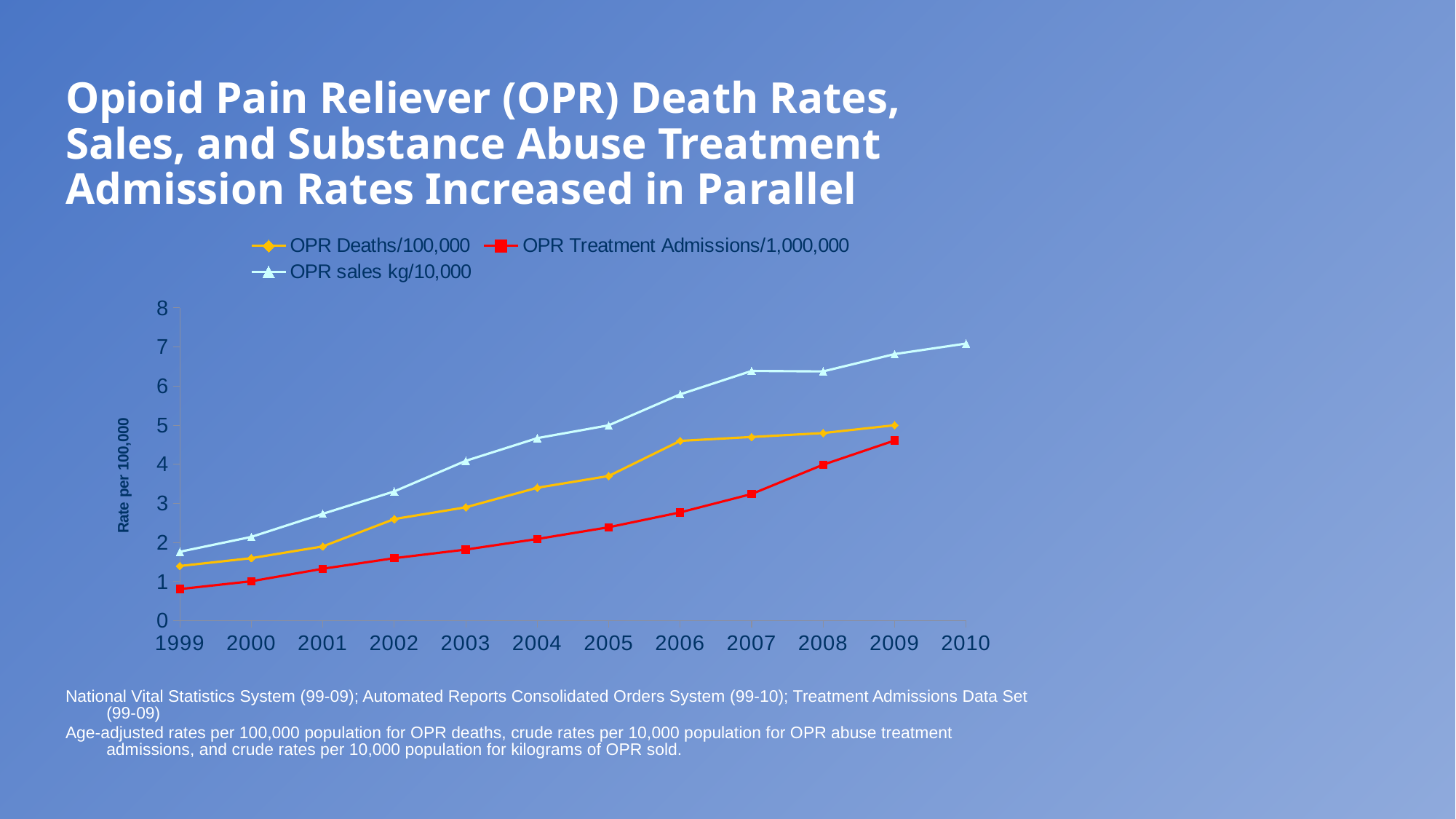
Is the value for OPR Treatment Admissions/1,000,000 in 1999 greater or less than 2? less In which year is the OPR sales kg/10,000 value highest? 2010 Which series has the highest value in 2009? OPR sales kg/10,000 How many series does the legend list? 3 Do the OPR sales kg/10,000 values rise or fall from 1999 to 2010? rise In 2005, which is larger: OPR Deaths/100,000 or OPR Treatment Admissions/1,000,000? OPR Deaths/100,000 What is the title of the y axis? Rate per 100,000 How many years are shown on the x axis? 12 Is the value for OPR Deaths/100,000 in 2006 greater or less than 4? greater What kind of chart is shown on the slide? line chart Is the value for OPR sales kg/10,000 in 2009 greater or less than 6? greater In which year is the OPR Deaths/100,000 value lowest? 1999